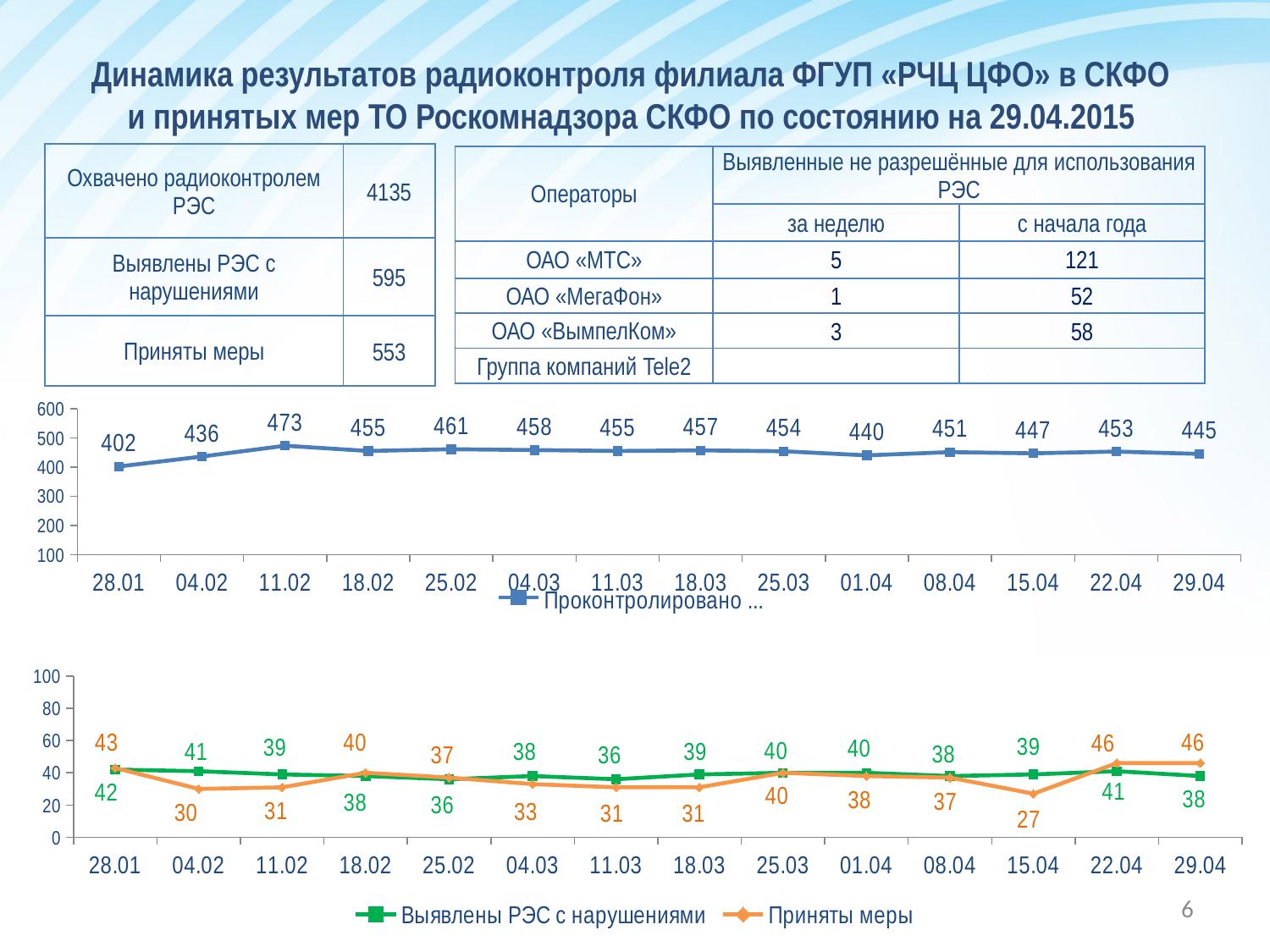
In the top line chart, which date has the lowest value? 28.01 In the top line chart, which date has the highest value? 11.02 In the bottom chart, what is the difference between 'Выявлены РЭС с нарушениями' and 'Приняты меры' on 04.02? 11 In the bottom chart, what is the value of 'Приняты меры' for 15.04? 27 How many data points are plotted in the top line chart? 14 In the top line chart, what is the value for 11.02? 473 In the bottom chart, which date has the lowest value for 'Приняты меры'? 15.04 In the bottom chart, what is the value of 'Выявлены РЭС с нарушениями' for 28.01? 42 In the top line chart, what is the difference between the values for 11.02 and 28.01? 71 What type of chart is the top chart on the slide? Line chart How many series does the legend of the bottom chart list? 2 In the bottom chart, which is larger on 22.04: 'Выявлены РЭС с нарушениями' or 'Приняты меры'? Приняты меры